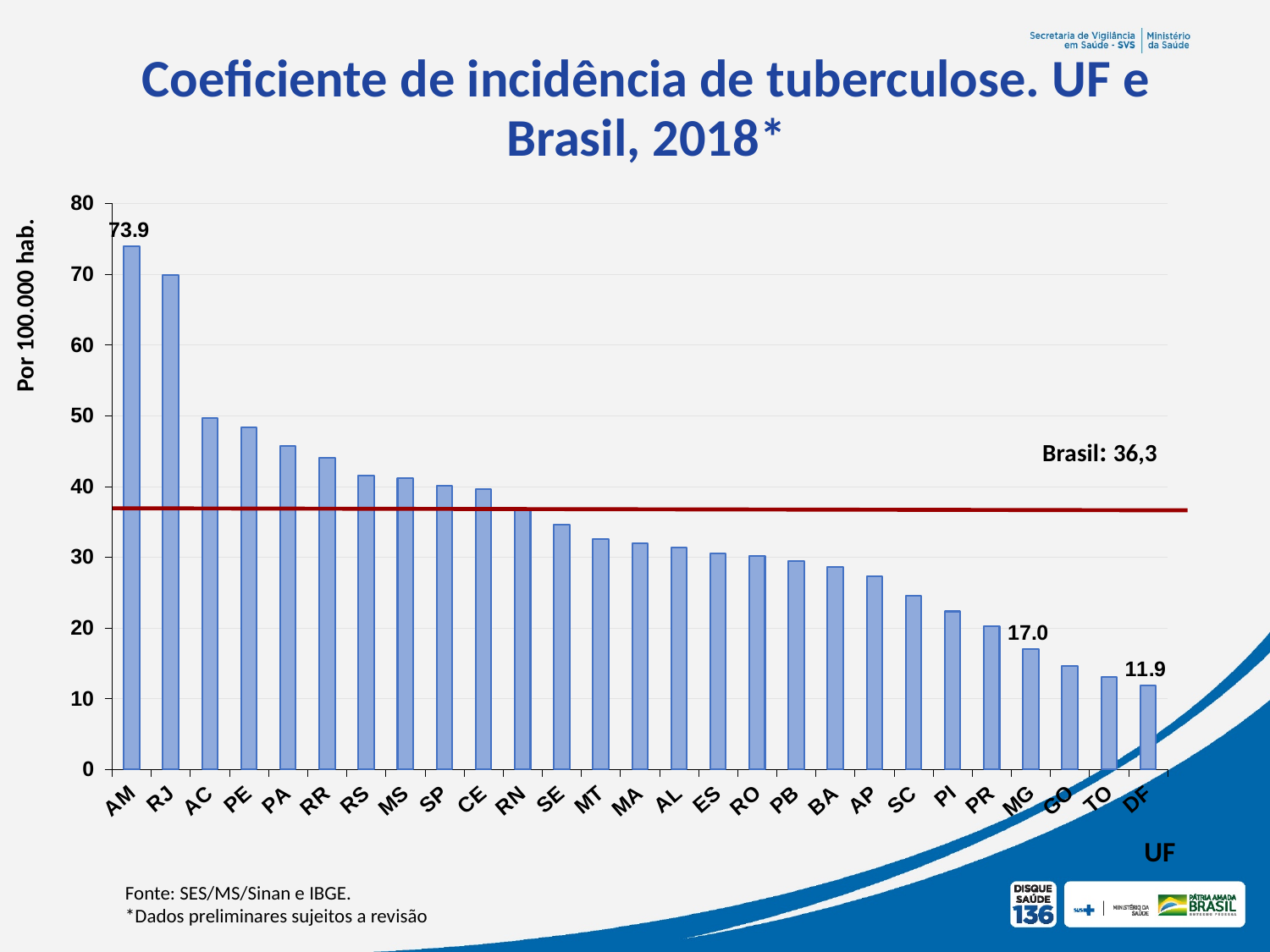
What is the difference between the values for AM and DF? 62.0 What is the tuberculosis incidence coefficient for DF? 11.9 Which has a higher incidence coefficient, RJ or AC? RJ Which UF has the lowest incidence coefficient? DF What is the tuberculosis incidence coefficient for MG? 17.0 Which UF has the highest incidence coefficient? AM Is the value for SE greater or less than 40? less Do the values rise or fall from left to right along the x axis? fall What value is shown for Brasil on the reference line? 36,3 What is the tuberculosis incidence coefficient for AM? 73.9 How many UFs are shown on the x axis? 27 Is the value for RJ greater or less than 60? greater